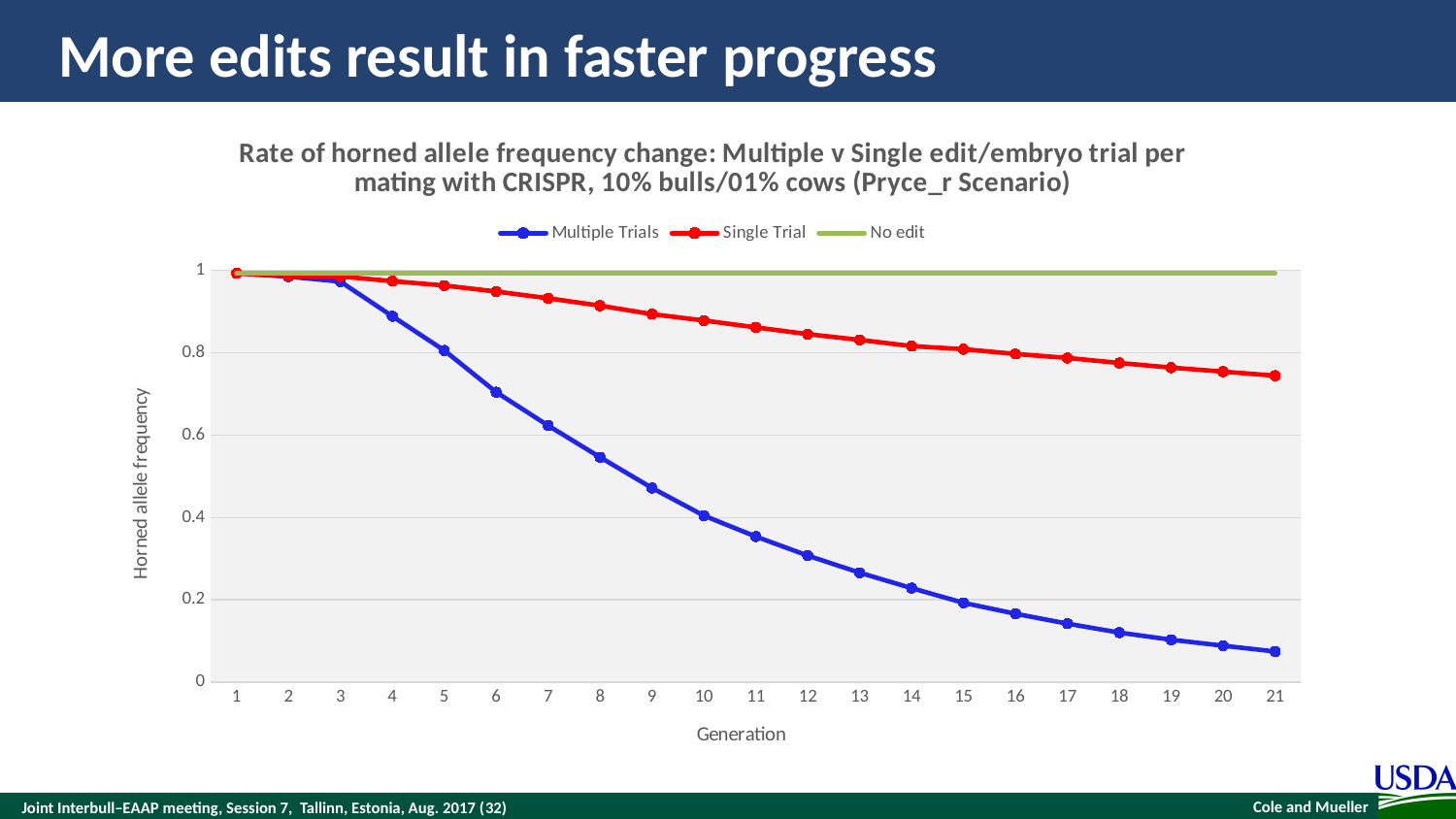
What is the label of the y axis? Horned allele frequency How many generations are plotted along the x axis? 21 Which series has the lowest horned allele frequency at generation 21? Multiple Trials What kind of chart is shown on the slide? line chart Is the value for Multiple Trials at generation 10 greater or less than 0.6? less Is the value for Multiple Trials at generation 5 greater or less than 0.6? greater What colour is the Single Trial line? red Does the Multiple Trials series rise or fall as generation increases? fall Does the No edit series rise, fall, or stay flat across generations? stay flat Is the value for Single Trial at generation 21 greater or less than 0.6? greater At generation 15, which is higher: Multiple Trials or Single Trial? Single Trial How many series does the legend list? 3